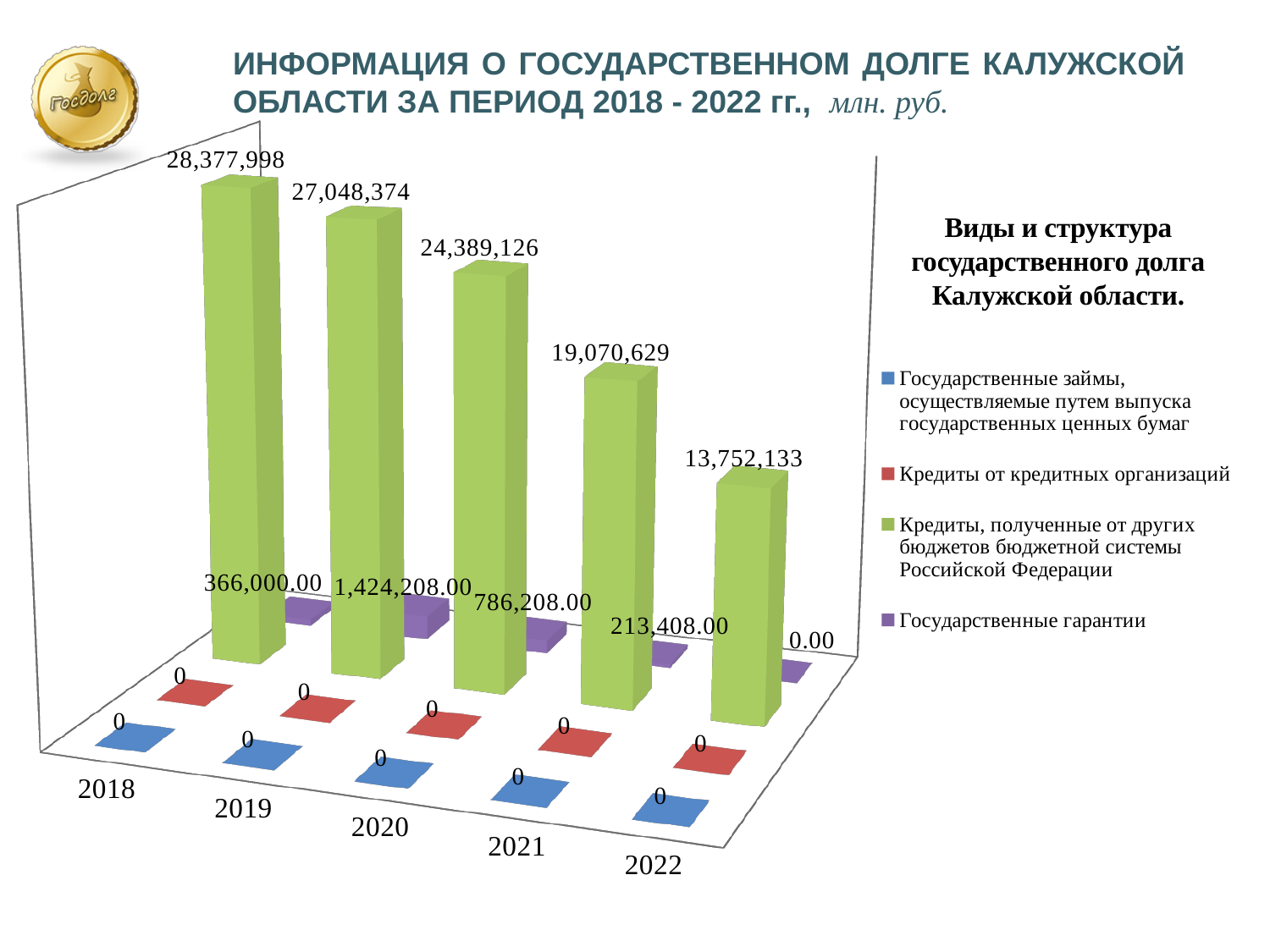
What is the value for 'Государственные гарантии' in 2022? 0.00 Do the values for 'Кредиты, полученные от других бюджетов бюджетной системы Российской Федерации' rise or fall from 2018 to 2022? Fall What is the value for 'Государственные гарантии' in 2019? 1,424,208.00 What is the difference between the 2018 and 2019 values for 'Кредиты, полученные от других бюджетов бюджетной системы Российской Федерации'? 1,329,624 How many years are shown on the x axis? 5 How many series does the legend list? 4 What kind of chart is shown on the slide? Bar chart In which year is the value for 'Государственные гарантии' highest? 2019 In which year is the value for 'Кредиты, полученные от других бюджетов бюджетной системы Российской Федерации' lowest? 2022 What is the value for 'Кредиты, полученные от других бюджетов бюджетной системы Российской Федерации' in 2022? 13,752,133 Which is larger: the 'Государственные гарантии' value in 2020 or in 2021? 2020 What is the value for 'Кредиты, полученные от других бюджетов бюджетной системы Российской Федерации' in 2018? 28,377,998